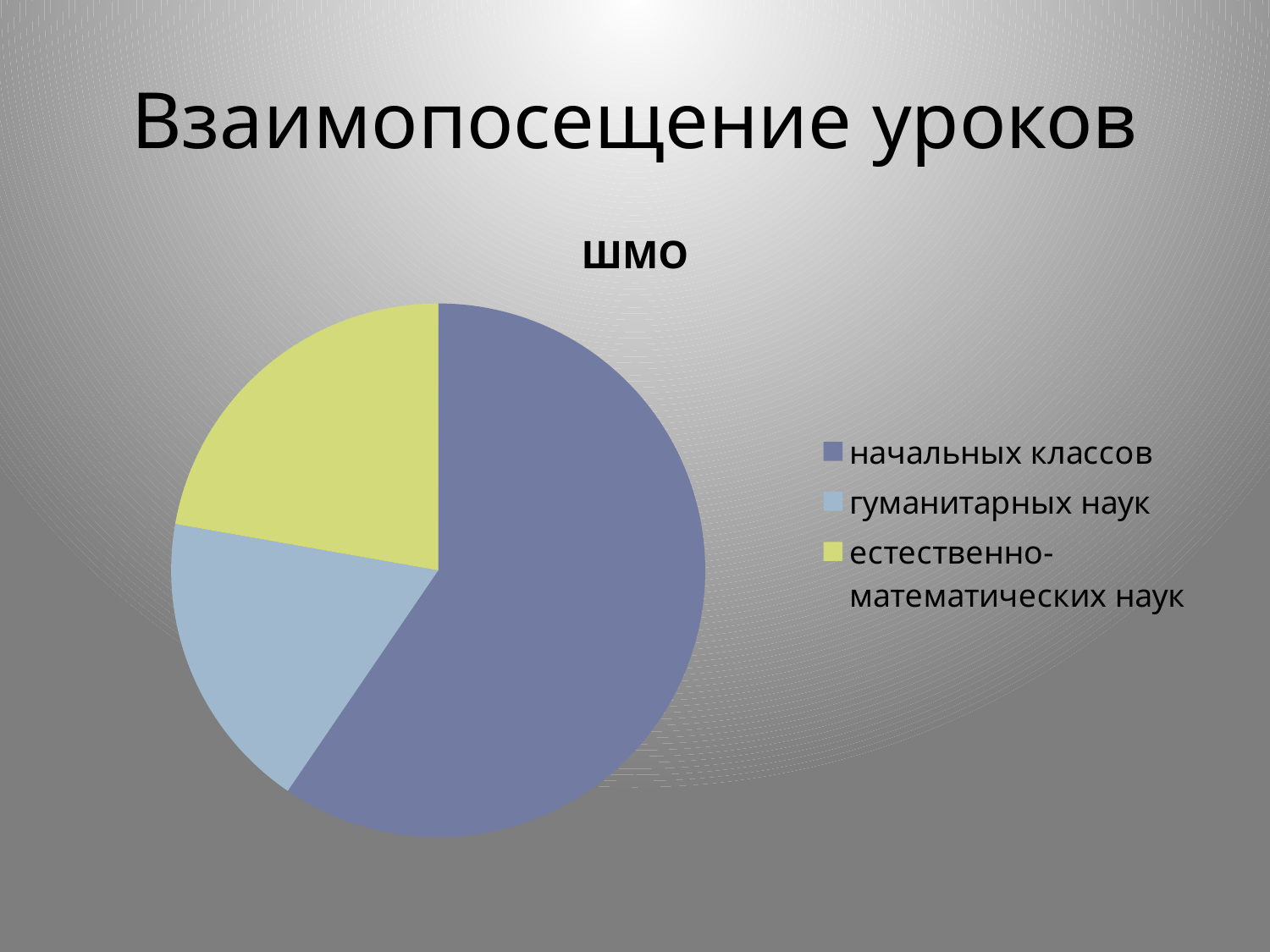
Which is larger: the slice for начальных классов or the slice for естественно-математических наук? начальных классов Which category is shown in yellow in the pie chart? естественно-математических наук What is the title of the chart? ШМО Which category has the largest slice of the pie? начальных классов What kind of chart is shown on the slide? pie chart How many slices does the pie chart have? 3 Which is larger: the slice for начальных классов or the slice for гуманитарных наук? начальных классов Does the slice for начальных классов take up more or less than half of the pie? more How many entries does the legend list? 3